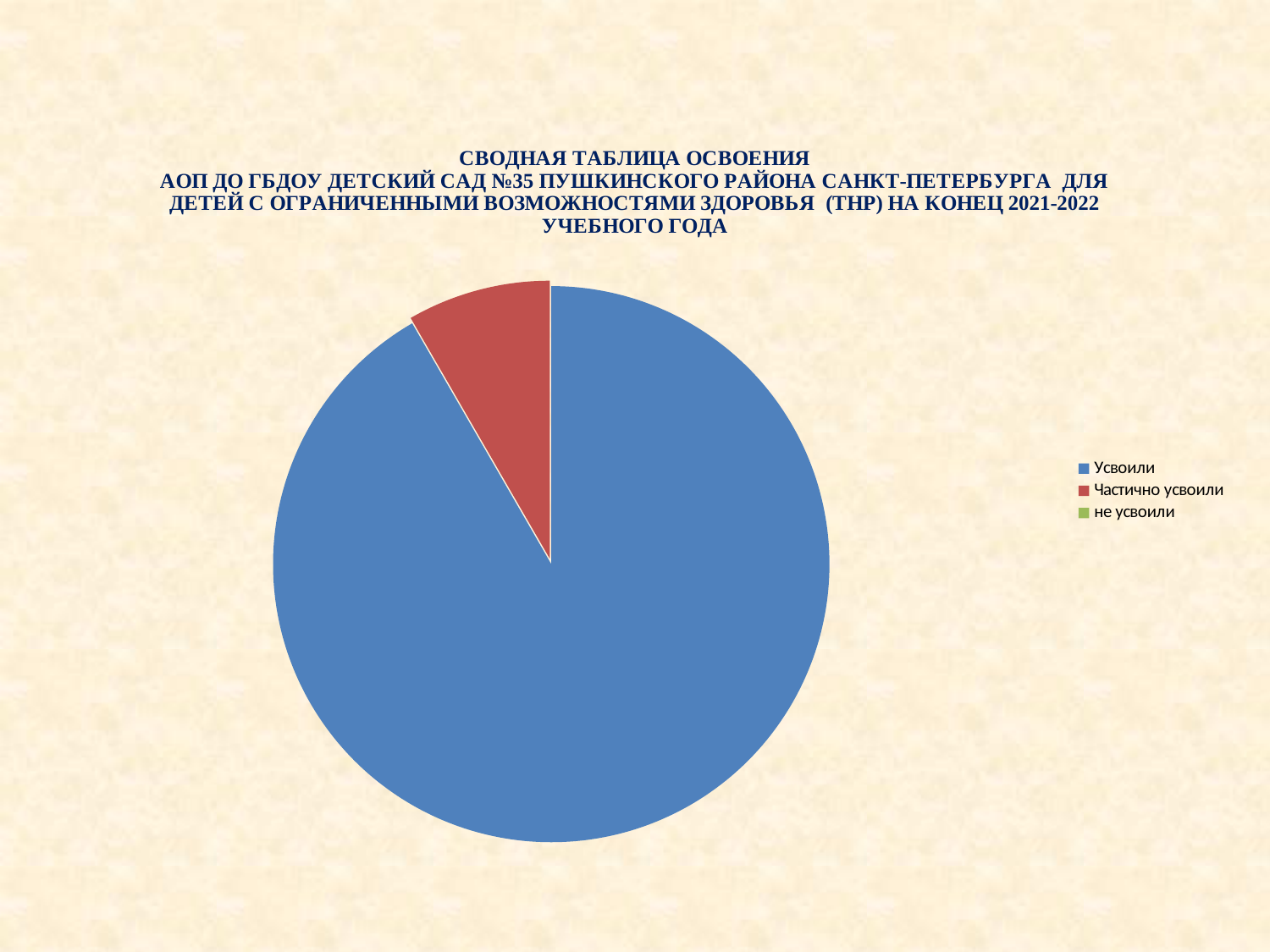
How many slices are visible in the pie chart? 2 What colour is the slice for Усвоили? blue What colour is the slice for Частично усвоили? red Which slice is smaller, Усвоили or Частично усвоили? Частично усвоили Which slice is larger, Усвоили or Частично усвоили? Усвоили Does the Усвоили slice take up more or less than half of the pie? more What kind of chart is shown on the slide? pie chart How many entries does the legend of the pie chart list? 3 Which category takes up the largest slice of the pie? Усвоили